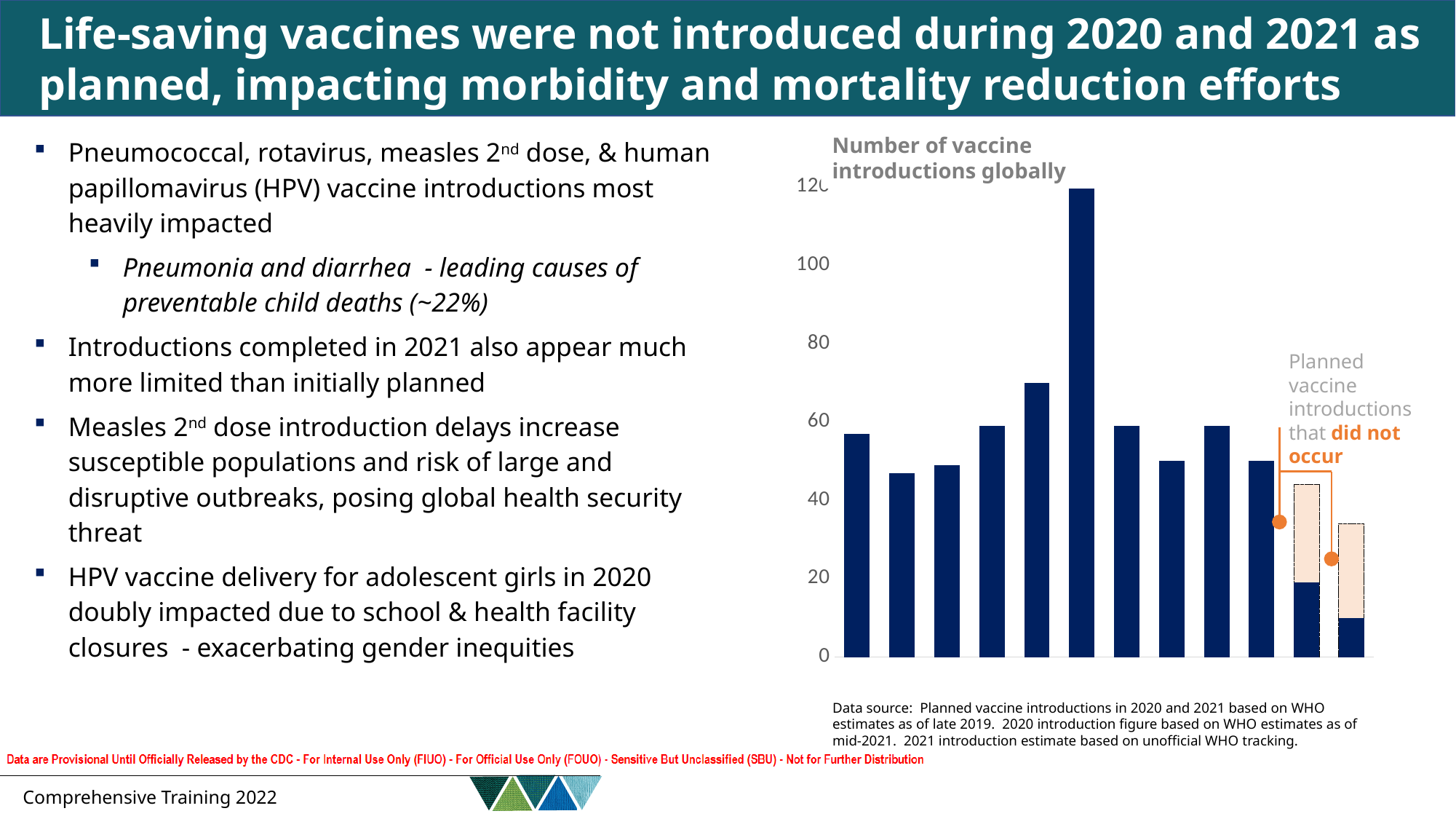
Is the value of the tallest bar in the chart greater or less than 100? greater Is the value of the first (leftmost) bar greater or less than 40? greater How many bars are plotted in the chart? 12 What is the title of the chart? Number of vaccine introductions globally What is the highest tick value shown on the y axis? 120 What kind of chart is shown on the slide? bar chart Is the dark-blue portion of the last (rightmost) bar greater or less than 20? less How many bars include a light, dashed-outline portion representing planned introductions that did not occur? 2